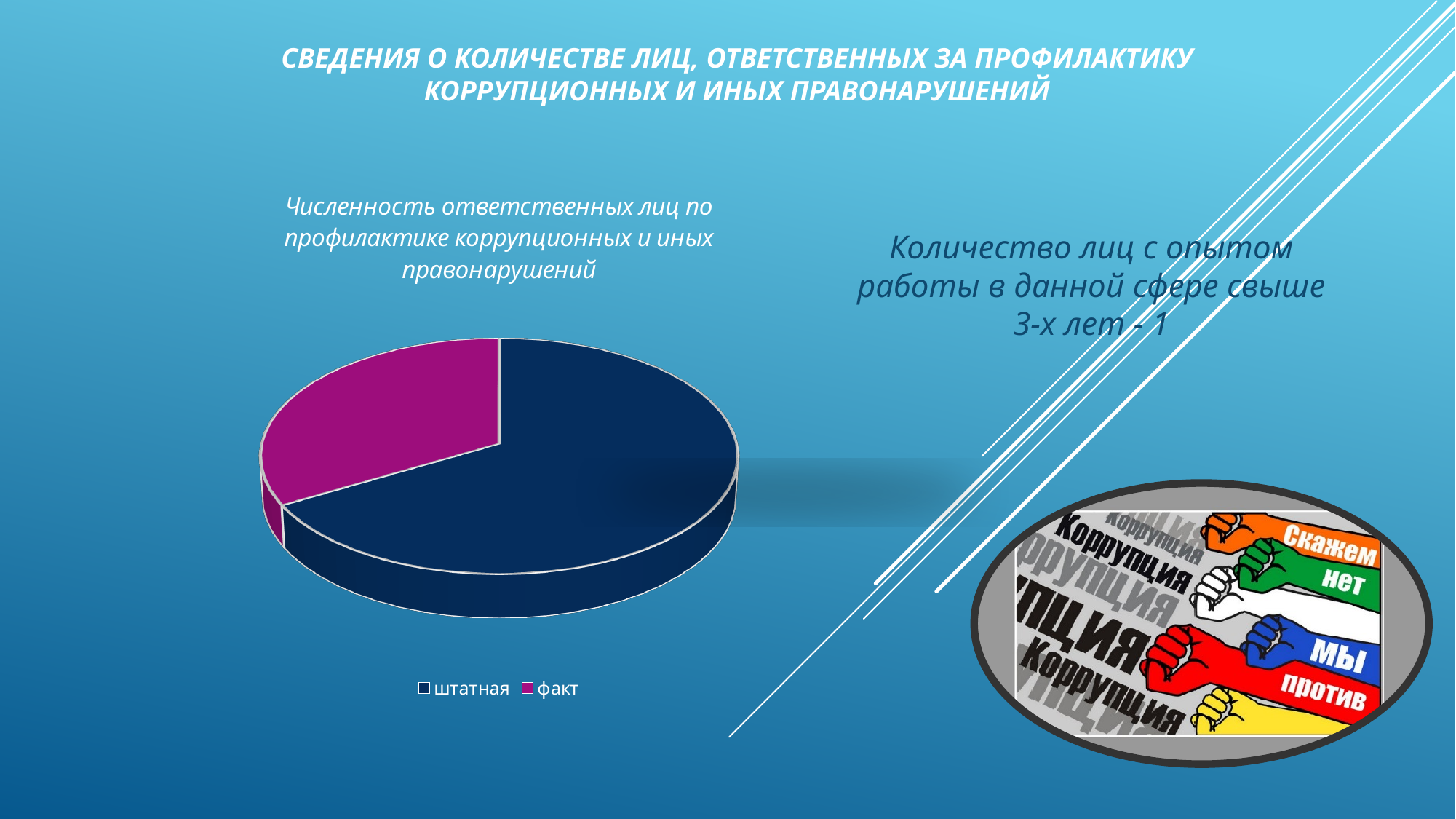
What kind of chart is shown on the slide? pie chart What colour is the slice for факт in the pie chart? magenta What is the title of the pie chart? Численность ответственных лиц по профилактике коррупционных и иных правонарушений Which slice is larger in the pie chart, штатная or факт? штатная Which category has the smallest slice in the pie chart? факт Which category has the largest slice in the pie chart? штатная How many slices does the pie chart have? 2 How many entries does the legend of the pie chart list? 2